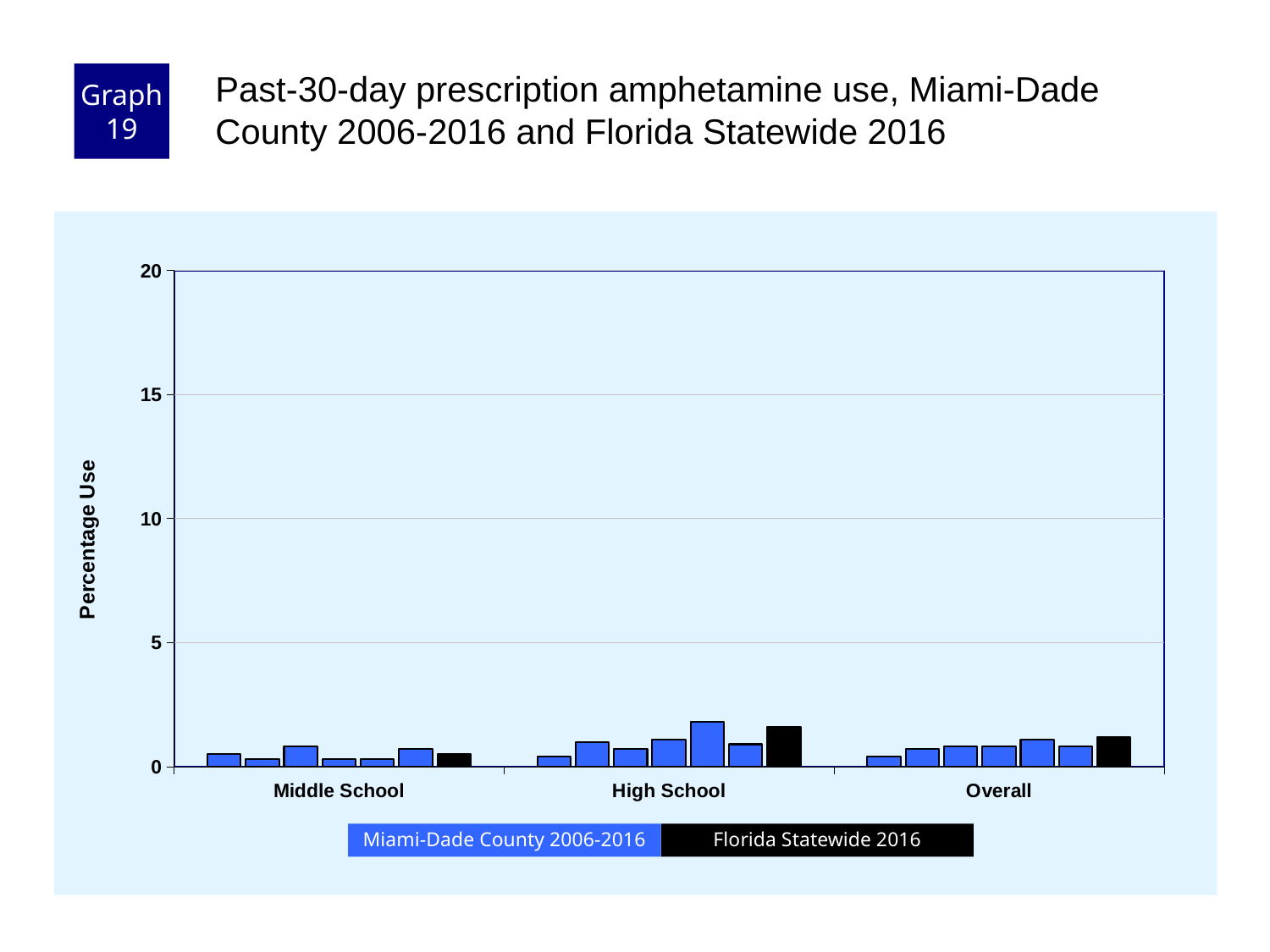
What is the title of the chart? Past-30-day prescription amphetamine use, Miami-Dade County 2006-2016 and Florida Statewide 2016 Which category has the lowest Florida Statewide 2016 value? Middle School How many series does the legend list? 2 What is the label on the y axis? Percentage Use Is the Florida Statewide 2016 value for Overall greater or less than 5? less What kind of chart is shown on the slide? bar chart Which category has the highest Florida Statewide 2016 value? High School Is the Florida Statewide 2016 value for High School greater or less than 5? less For Florida Statewide 2016, is the value for Overall larger or smaller than the value for Middle School? larger How many categories are shown on the x axis? 3 Is the Florida Statewide 2016 value for Middle School greater or less than 5? less Which category has the tallest bar in the chart? High School